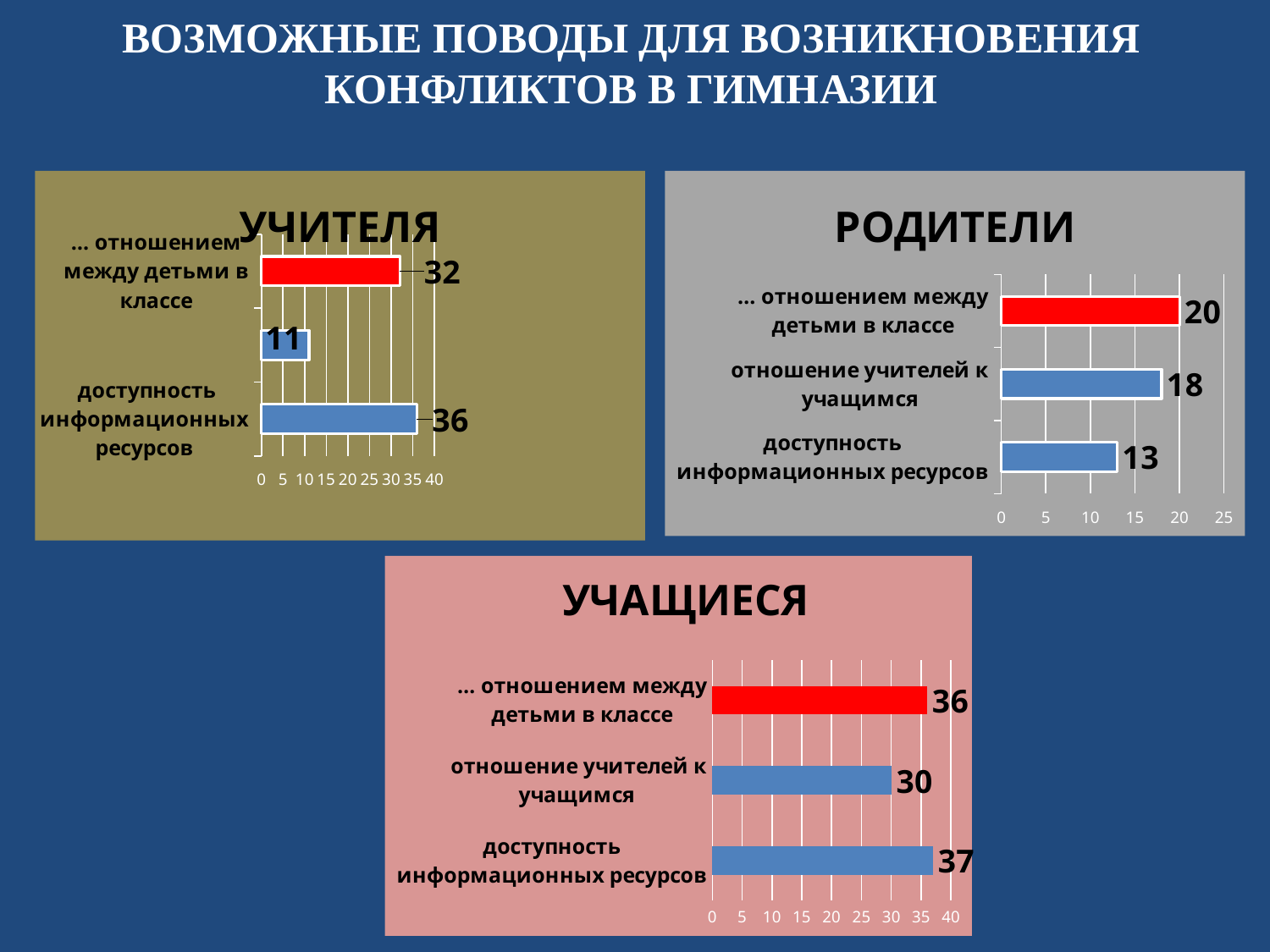
In the УЧИТЕЛЯ chart, which category has the highest value? доступность информационных ресурсов In the РОДИТЕЛИ chart, what is the difference between ... отношением между детьми в классе and доступность информационных ресурсов? 7 What type of chart is the РОДИТЕЛИ chart? bar chart In the РОДИТЕЛИ chart, which category has the lowest value? доступность информационных ресурсов In the УЧИТЕЛЯ chart, what is the value for ... отношением между детьми в классе? 32 In the УЧАЩИЕСЯ chart, which category has the highest value? доступность информационных ресурсов In the УЧИТЕЛЯ chart, what is the value for доступность информационных ресурсов? 36 In the УЧАЩИЕСЯ chart, what is the value for отношение учителей к учащимся? 30 In the УЧАЩИЕСЯ chart, which is larger: ... отношением между детьми в классе or отношение учителей к учащимся? ... отношением между детьми в классе In the УЧАЩИЕСЯ chart, what colour is the bar for ... отношением между детьми в классе? red In the РОДИТЕЛИ chart, what is the value for отношение учителей к учащимся? 18 How many categories does the УЧАЩИЕСЯ chart show? 3